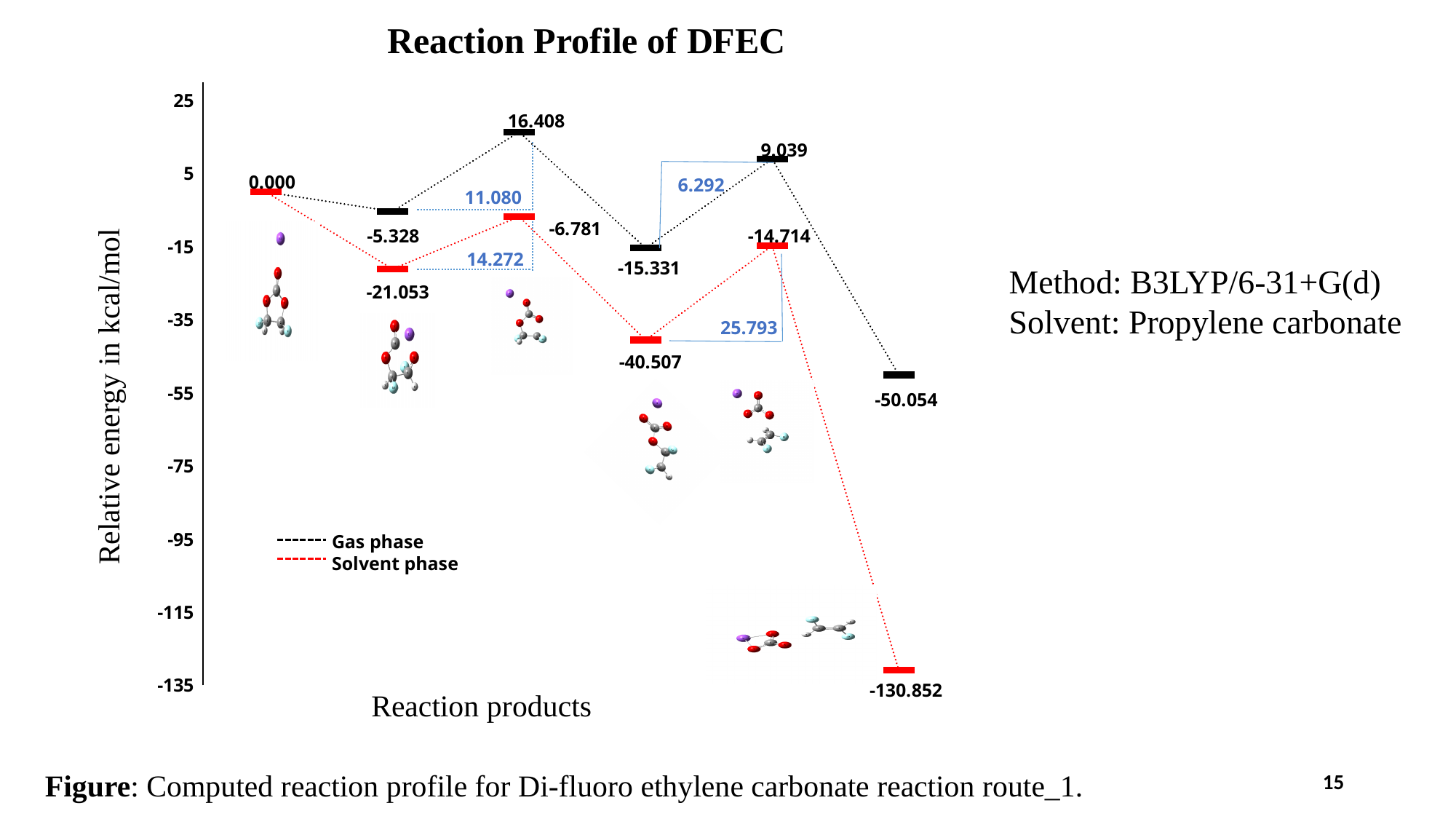
How many series does the legend list? 2 What is the value of the fourth point on the Gas phase series? -15.331 Which series is drawn in red according to the legend? Solvent phase What is the value of the final (rightmost) point on the Gas phase series? -50.054 How many energy levels are plotted for the Gas phase series? 6 What is the lowest labelled value on the Solvent phase series? -130.852 Which series has the lower final value, Gas phase or Solvent phase? Solvent phase What is the highest labelled value on the Gas phase series? 16.408 What is the difference between the final Gas phase value (-50.054) and the final Solvent phase value (-130.852)? 80.798 What is the value of the second point on the Solvent phase series? -21.053 What is the title of the chart? Reaction Profile of DFEC What is the label of the y axis? Relative energy in kcal/mol